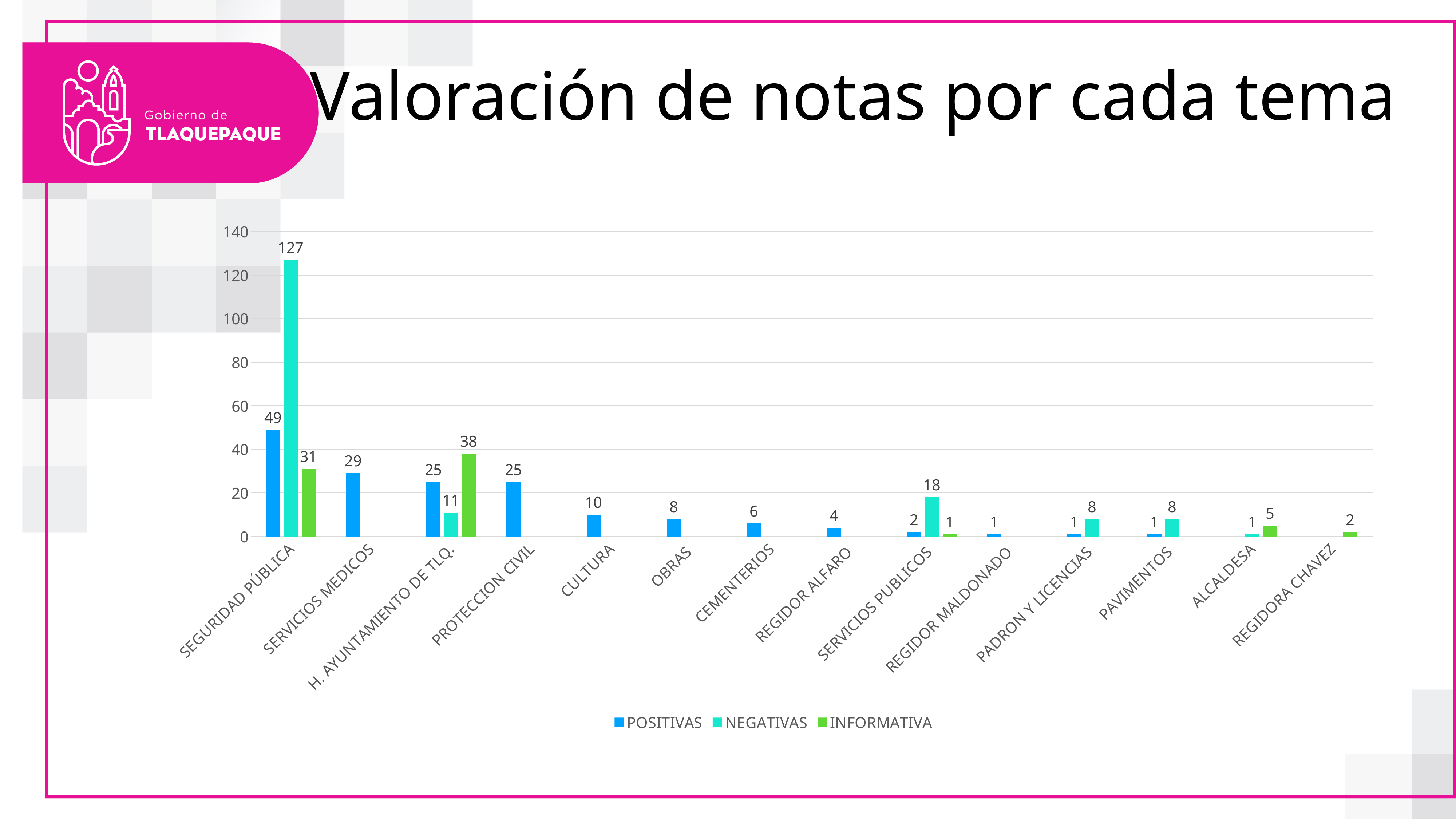
How many series does the legend list? 3 Which category has the highest POSITIVAS value? SEGURIDAD PÚBLICA Which is larger for H. AYUNTAMIENTO DE TLQ., the POSITIVAS value or the INFORMATIVA value? INFORMATIVA What is the POSITIVAS value for CULTURA? 10 What kind of chart is shown on the slide? Bar chart How many categories are shown on the x axis? 14 What is the NEGATIVAS value for SERVICIOS PUBLICOS? 18 What is the NEGATIVAS value for SEGURIDAD PÚBLICA? 127 What is the INFORMATIVA value for H. AYUNTAMIENTO DE TLQ.? 38 What is the title of the chart on the slide? Valoración de notas por cada tema Is the NEGATIVAS value for SEGURIDAD PÚBLICA greater or less than 120? greater What is the difference between the NEGATIVAS and POSITIVAS values for SEGURIDAD PÚBLICA? 78